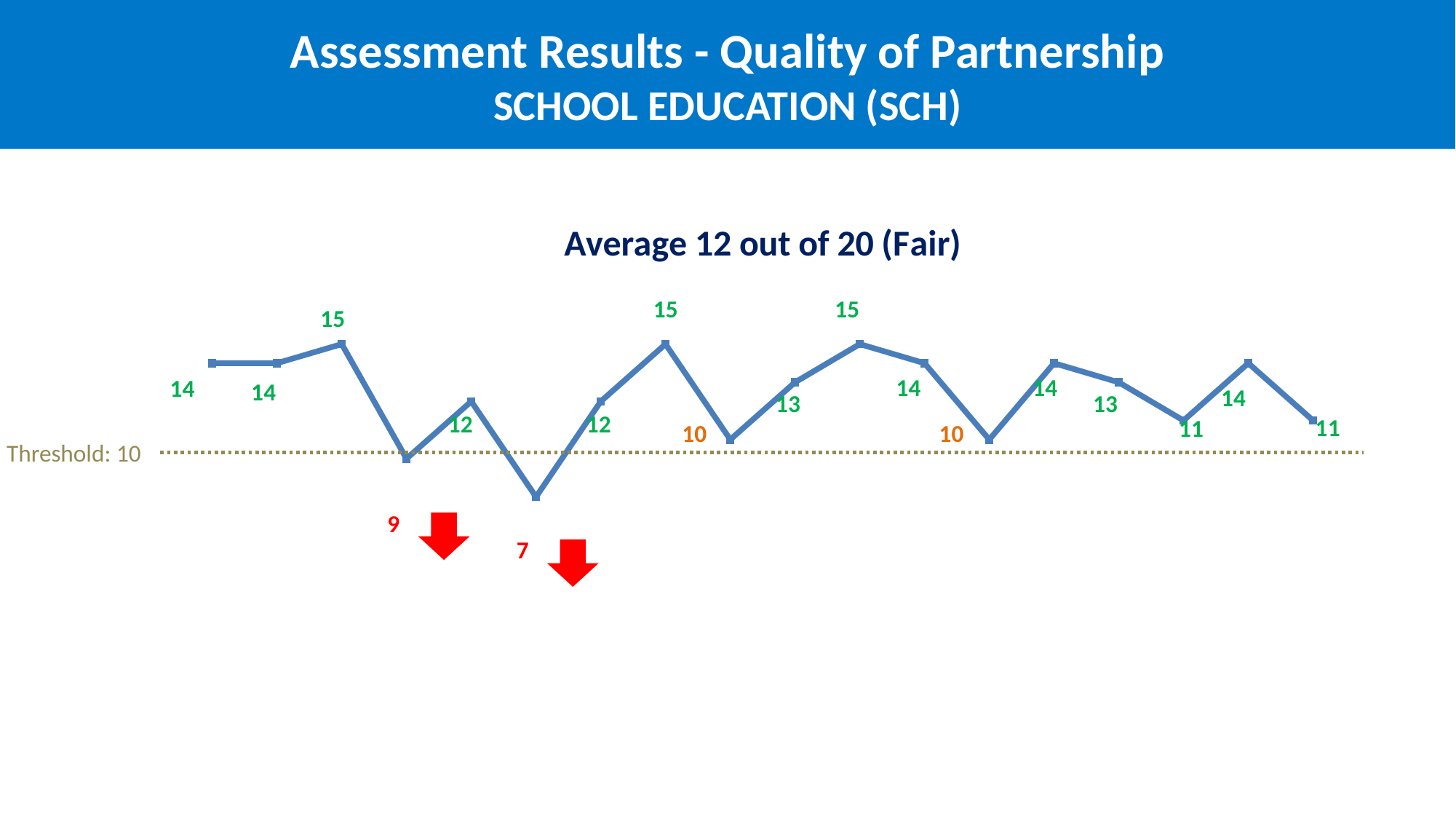
What is the highest value plotted on the line? 15 What is the title shown above the chart? Average 12 out of 20 (Fair) What is the value of the first (leftmost) point on the line? 14 How many data points are plotted on the line? 18 What is the difference between the highest and lowest values on the line? 8 How many points on the line fall below the threshold line? 2 Which is larger, the first point on the line or the last point? the first point How many points on the line have a value of 15? 3 What kind of chart is shown on the slide? line chart What is the lowest value plotted on the line? 7 What is the value of the last (rightmost) point on the line? 11 What value does the dotted threshold line represent? 10